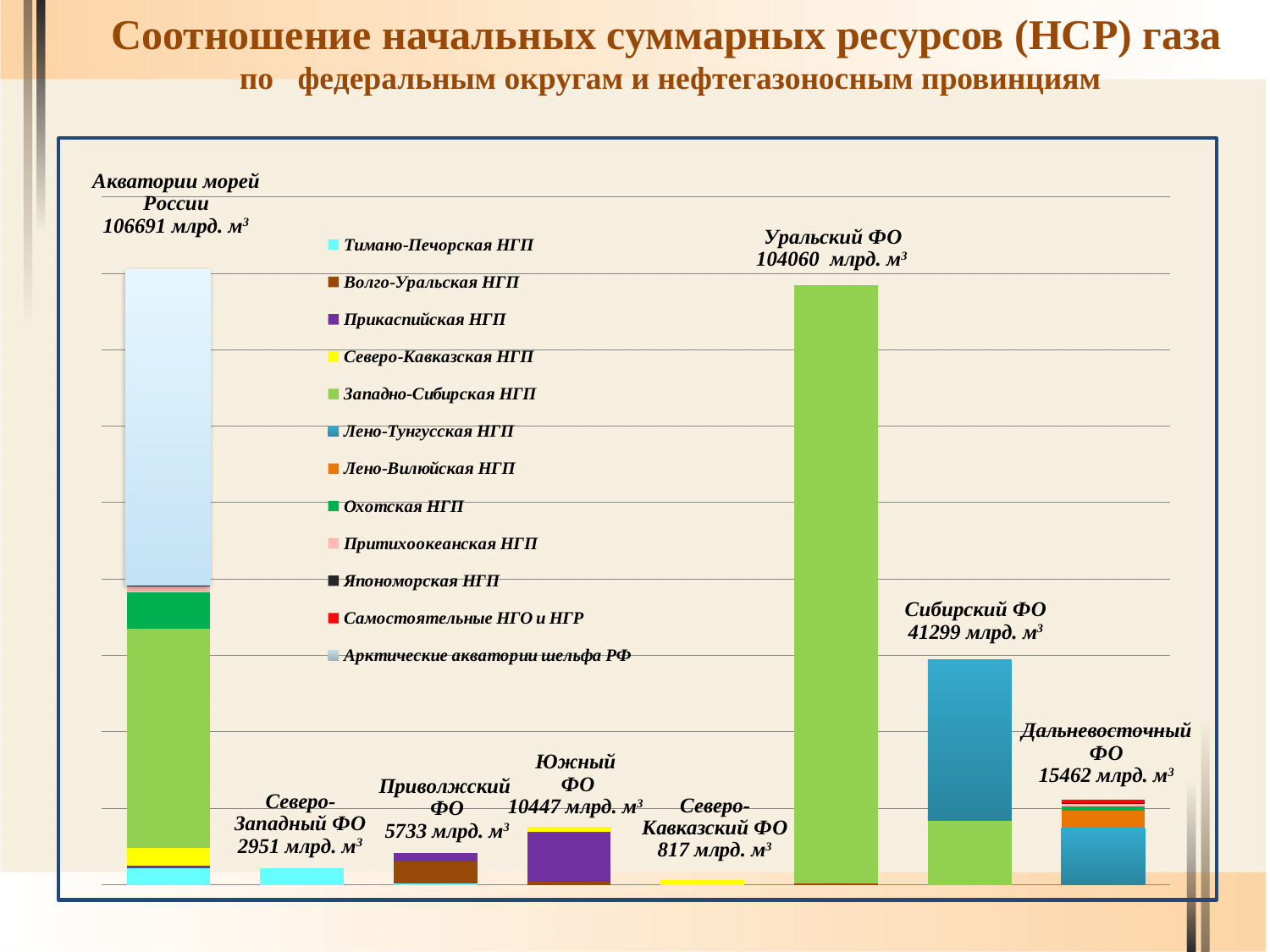
What is the total value shown for Уральский ФО? 104060 млрд. м³ What kind of chart is shown on the slide? Stacked bar chart How many categories (bars) are shown on the chart? 8 What is the difference between the totals for Сибирский ФО and Дальневосточный ФО? 25837 млрд. м³ What is the difference between the totals for Акватории морей России and Уральский ФО? 2631 млрд. м³ Which has a larger total, Южный ФО or Приволжский ФО? Южный ФО Which category has the lowest total value? Северо-Кавказский ФО What is the total value shown for Сибирский ФО? 41299 млрд. м³ How many series does the legend list? 12 What is the total value shown for Акватории морей России? 106691 млрд. м³ What is the total value shown for Северо-Кавказский ФО? 817 млрд. м³ Which category has the highest total value? Акватории морей России